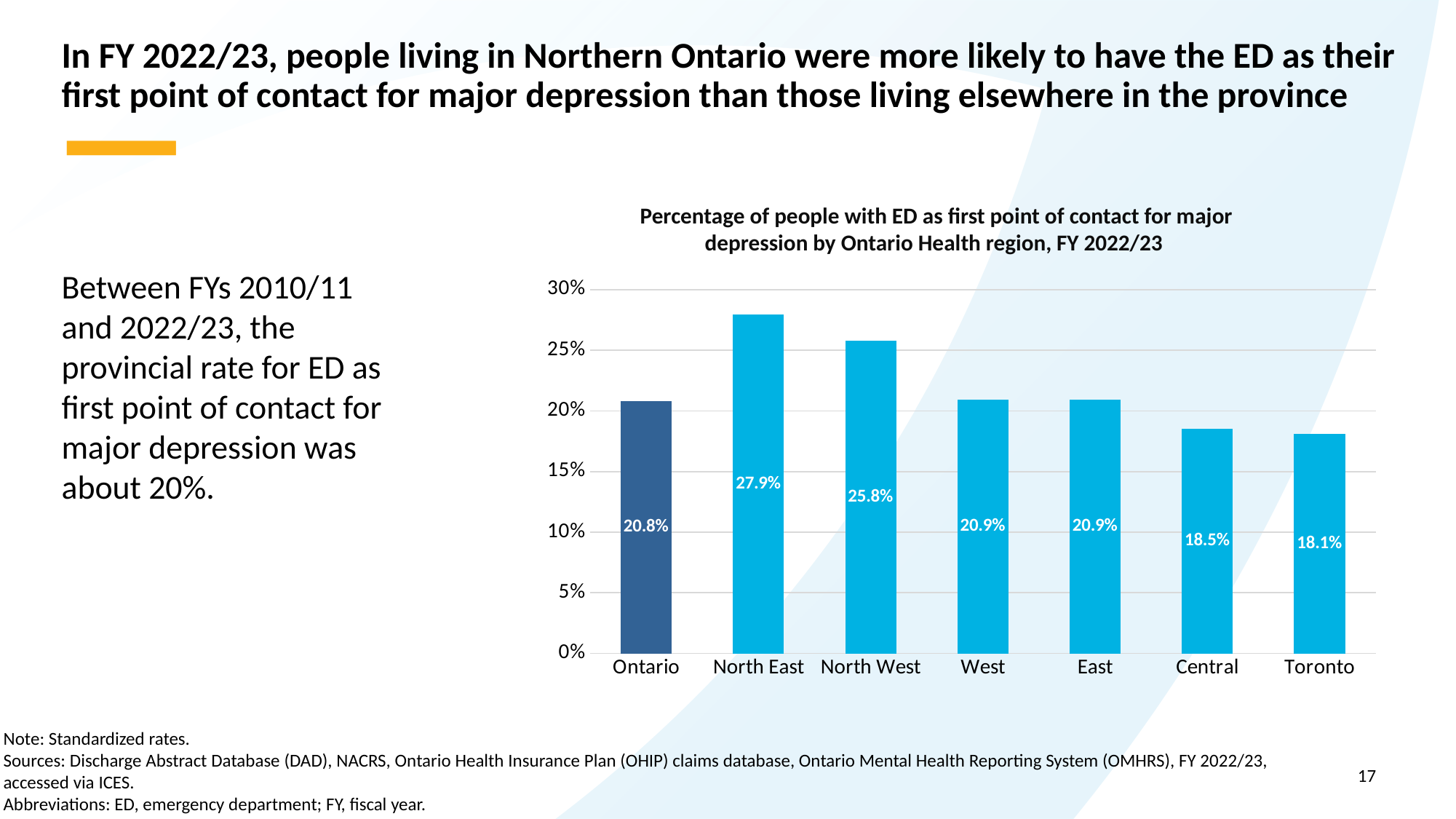
Which has a higher value, North West or West? North West What is the difference in percentage points between North East and North West? 2.1 What is the difference in percentage points between Central and Toronto? 0.4 Is the value for Central greater or less than 20%? less What is the value shown for Toronto? 18.1% What is the value shown for Ontario overall? 20.8% Which region has the lowest percentage? Toronto How many regions (bars) are shown in the chart? 7 Which bar is shown in a darker blue colour than the others? Ontario Which region has the highest percentage of people with ED as first point of contact for major depression? North East What is the percentage of people with ED as first point of contact for major depression in the North East region? 27.9% What type of chart is shown on the slide? Bar chart